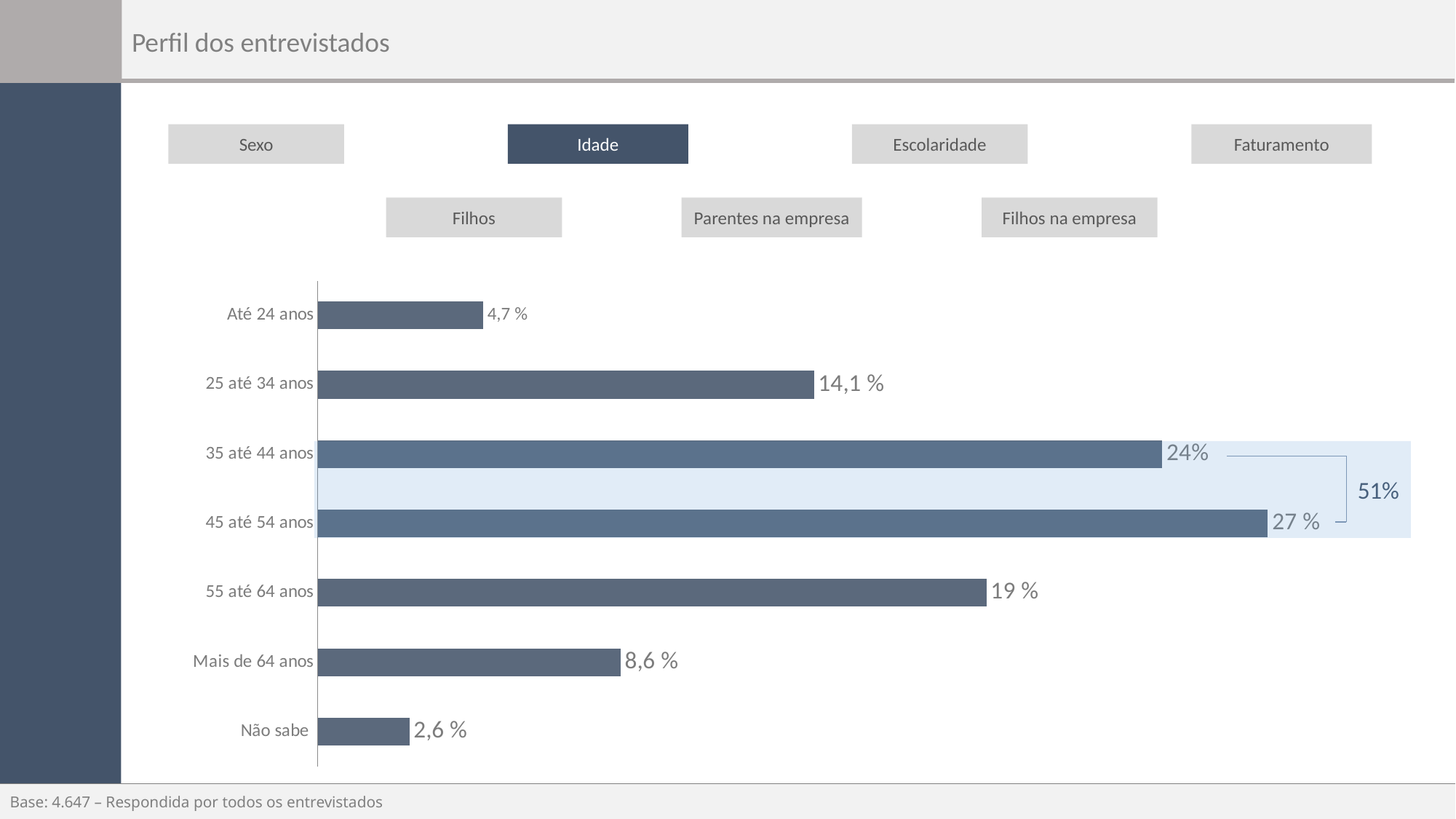
Which is larger, the value for "55 até 64 anos" or the value for "25 até 34 anos"? 55 até 64 anos Which category has the lowest value? Não sabe What combined percentage is shown for the highlighted "35 até 44 anos" and "45 até 54 anos" categories? 51% What is the base stated at the bottom of the slide? 4.647 What is the value for "Mais de 64 anos"? 8,6 % Which tab is highlighted in dark blue above the chart? Idade What is the difference between the values for "45 até 54 anos" and "35 até 44 anos"? 3 percentage points What kind of chart is shown on the slide? Bar chart What is the value for "Não sabe"? 2,6 % How many categories are shown in the chart? 7 Which age category has the highest value? 45 até 54 anos What is the value for "25 até 34 anos"? 14,1 %